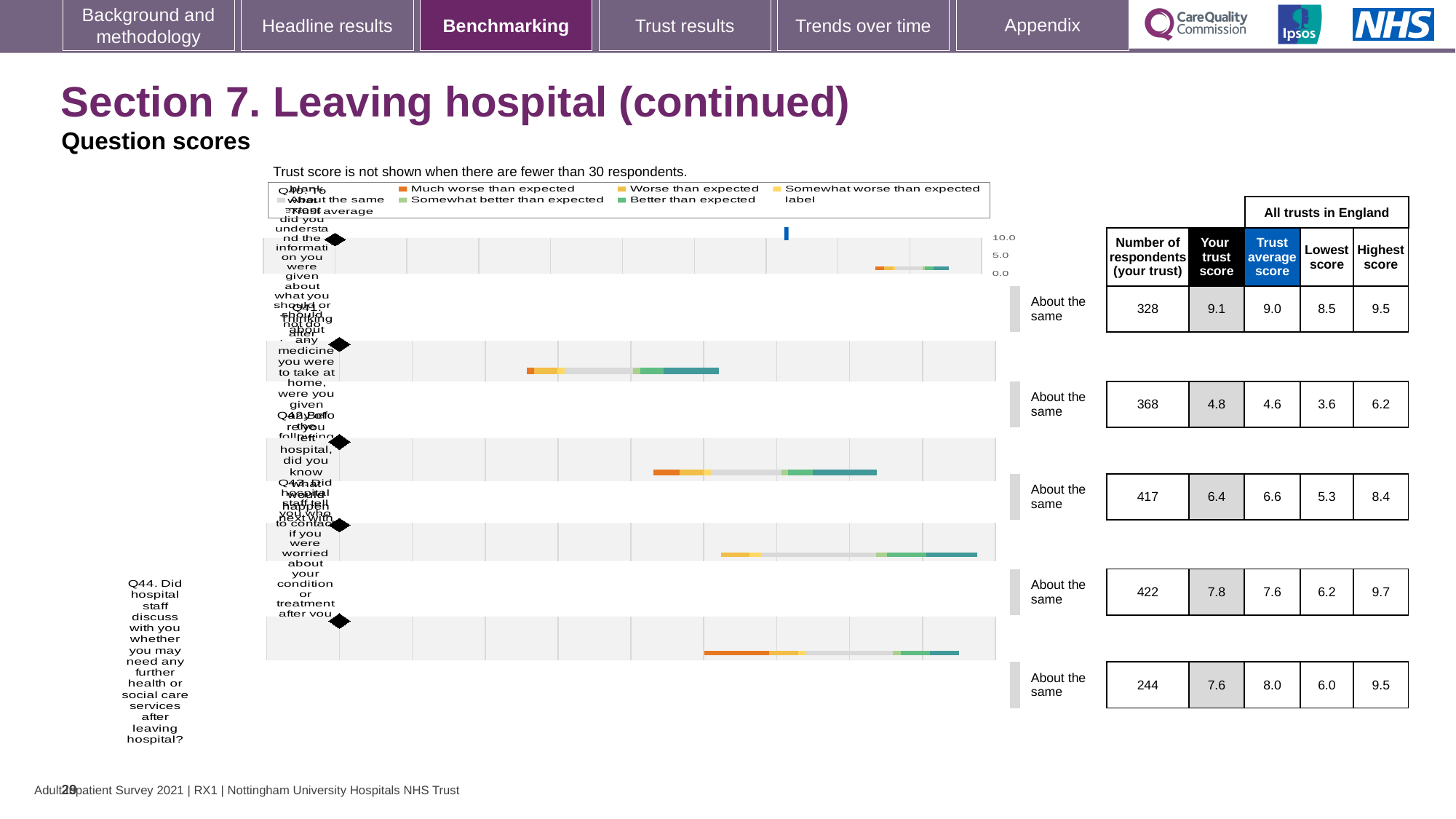
How many respondents (your trust) are shown for Q44, the bottom row? 244 For Q44 (bottom row), is 'Your trust score' higher or lower than the 'Trust average score'? lower What benchmark category label is shown next to every question row? About the same What is the highest 'Your trust score' value shown in the table? 9.1 What is the maximum tick value shown on the chart's score axis? 10.0 What is the 'Trust average score' for Q44, the bottom row? 8.0 How many question rows (bars) are plotted in the chart? 5 What is the lowest 'Your trust score' value shown in the table? 4.8 What kind of chart is used to show the question scores on this slide? bar chart In the row with 417 respondents, what is the Lowest score across all trusts in England? 5.3 For Q44 (bottom row), what is the difference between the Highest score and the Lowest score across all trusts in England? 3.5 What is the 'Your trust score' for Q44 (the bottom row of the table)? 7.6